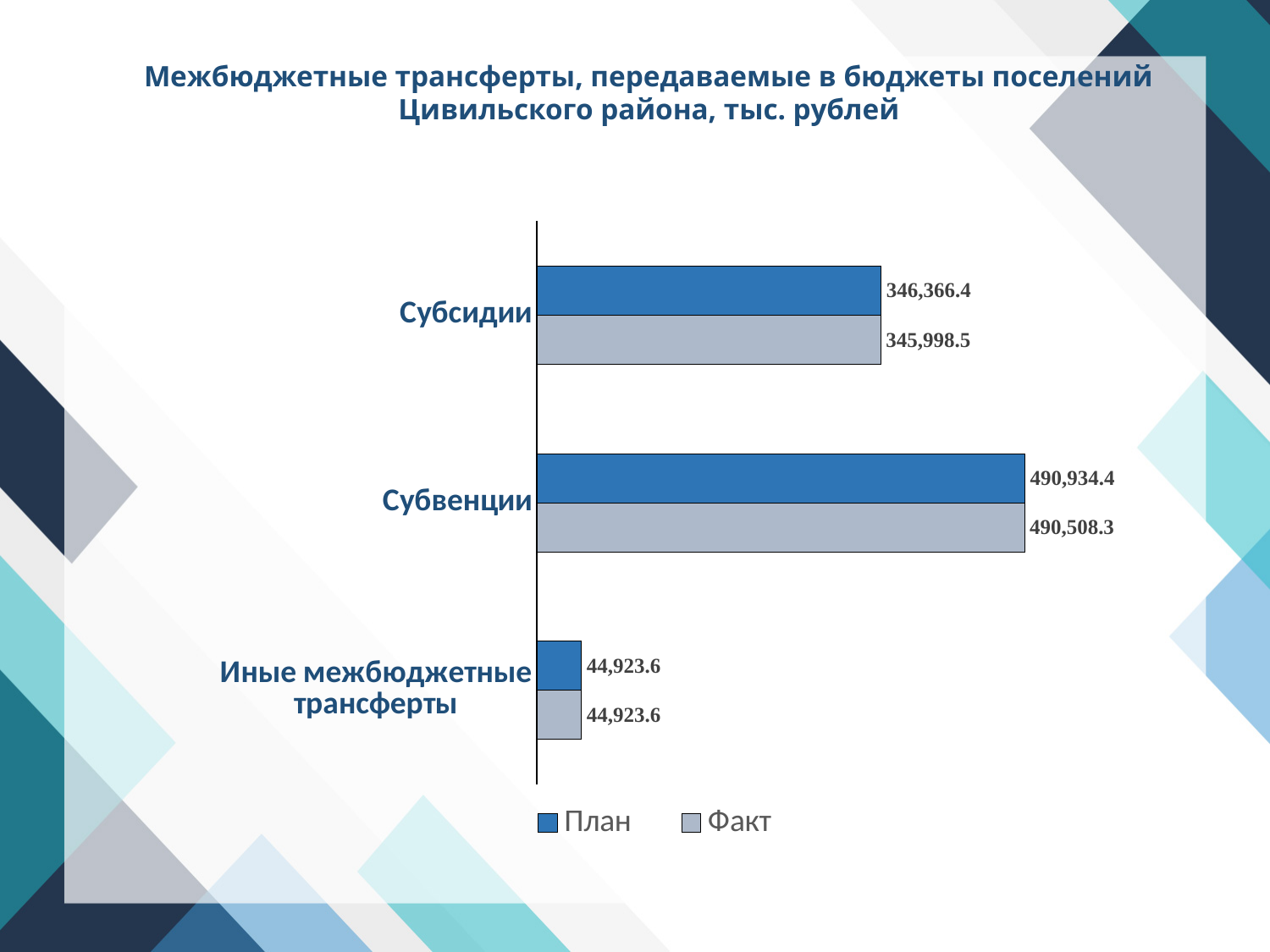
What are the two series named in the legend? План and Факт How many series does the legend list? 2 What is the Факт value for Иные межбюджетные трансферты? 44,923.6 What is the План value for Субсидии? 346,366.4 Which category has the lowest Факт value? Иные межбюджетные трансферты How many categories are shown on the chart? 3 What is the difference between the План and Факт values for Субсидии? 367.9 Which category has the highest План value? Субвенции Which is larger: the Факт value for Субвенции or the Факт value for Субсидии? Субвенции What is the Факт value for Субвенции? 490,508.3 What is the difference between the План and Факт values for Субвенции? 426.1 What kind of chart is shown on the slide? Bar chart